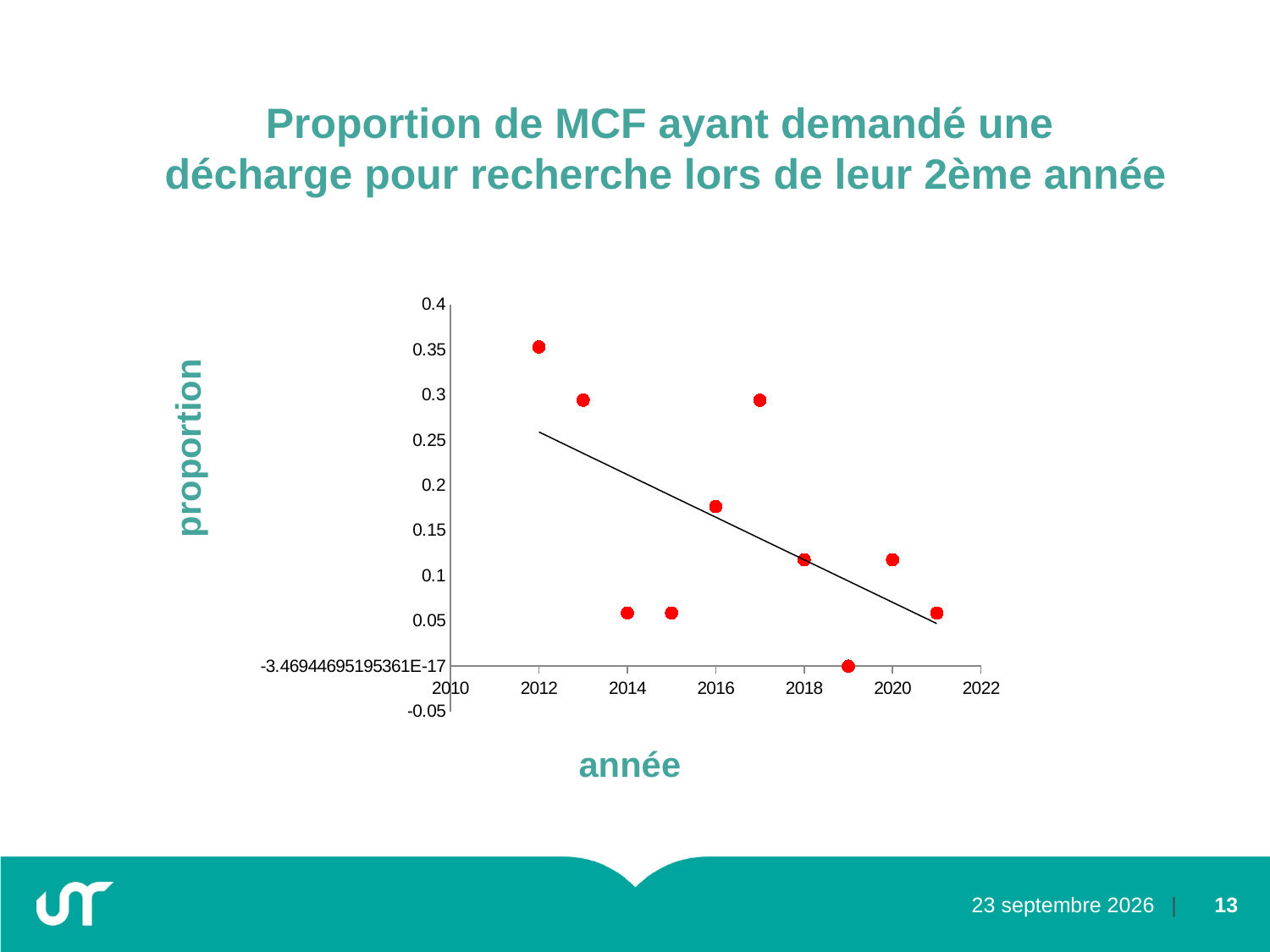
Which year has the lowest proportion? 2019 Is the proportion for 2012 greater or less than 0.3? greater How many data points are plotted in the chart? 10 Which year has the larger proportion, 2016 or 2018? 2016 Is the proportion for 2021 greater or less than 0.1? less What kind of chart is shown on the slide? scatter chart Is the proportion for 2016 greater or less than 0.15? greater Do the values generally rise or fall along the x axis according to the trend line? fall Which year has the highest proportion? 2012 What is the label of the horizontal axis? année What is the label of the vertical axis? proportion